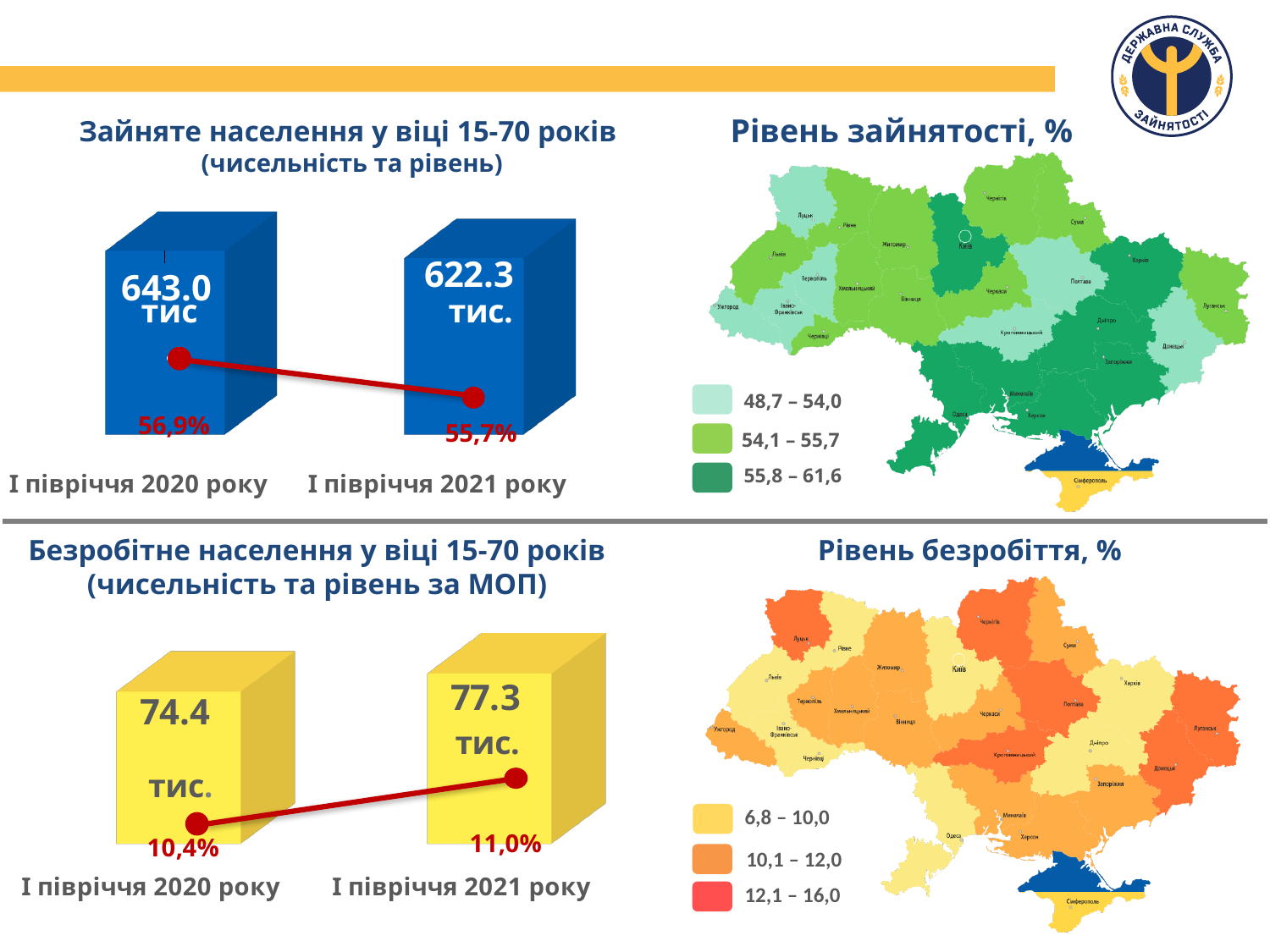
In the chart 'Безробітне населення у віці 15-70 років', what is the value for І півріччя 2021 року? 77.3 тис. In the chart 'Зайняте населення у віці 15-70 років', what is the value for І півріччя 2021 року? 622.3 тис. In the chart 'Зайняте населення у віці 15-70 років', what is the value for І півріччя 2020 року? 643.0 тис In the chart 'Безробітне населення у віці 15-70 років', what unemployment rate is shown for І півріччя 2020 року? 10,4% In the chart 'Безробітне населення у віці 15-70 років', what is the difference in the unemployment rate between І півріччя 2021 року and І півріччя 2020 року? 0,6% In the chart 'Безробітне населення у віці 15-70 років', which period has the higher number of unemployed people? І півріччя 2021 року In the chart 'Зайняте населення у віці 15-70 років', what employment rate is shown for І півріччя 2021 року? 55,7% In the chart 'Зайняте населення у віці 15-70 років', do the values rise or fall from І півріччя 2020 року to І півріччя 2021 року? fall In the map 'Рівень зайнятості, %', what range does the darkest green colour in the legend represent? 55,8 – 61,6 In the chart 'Зайняте населення у віці 15-70 років', by how much did the number of employed people (тис.) fall from І півріччя 2020 року to І півріччя 2021 року? 20.7 тис. What kind of chart is used for 'Безробітне населення у віці 15-70 років'? bar chart In the chart 'Безробітне населення у віці 15-70 років', what is the value for І півріччя 2020 року? 74.4 тис.